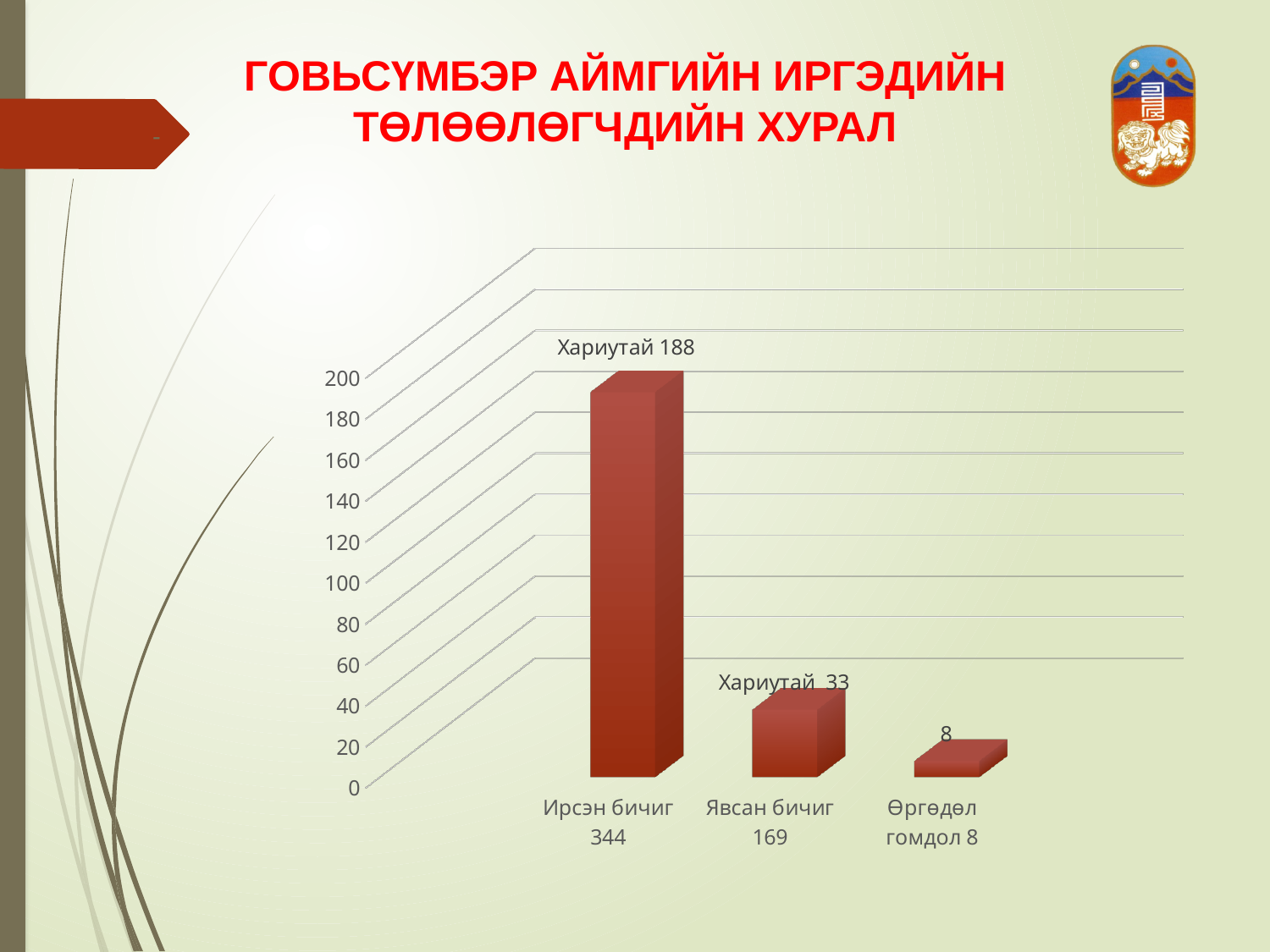
What is the highest tick value shown on the vertical axis? 200 What kind of chart is shown on the slide? bar chart How many categories are plotted on the chart? 3 Which category has the lowest bar? Өргөдөл гомдол 8 Which category has the highest bar? Ирсэн бичиг 344 Which is larger, the bar for "Явсан бичиг 169" or the bar for "Өргөдөл гомдол 8"? Явсан бичиг 169 What is the value shown for "Өргөдөл гомдол 8"? 8 What is the data label on the bar for "Явсан бичиг 169"? Хариутай 33 What is the difference between the values labelled for "Ирсэн бичиг 344" (188) and "Явсан бичиг 169" (33)? 155 Is the value for "Ирсэн бичиг 344" greater or less than 100? greater Do the bar values rise or fall from left to right along the x axis? fall What is the data label on the bar for "Ирсэн бичиг 344"? Хариутай 188